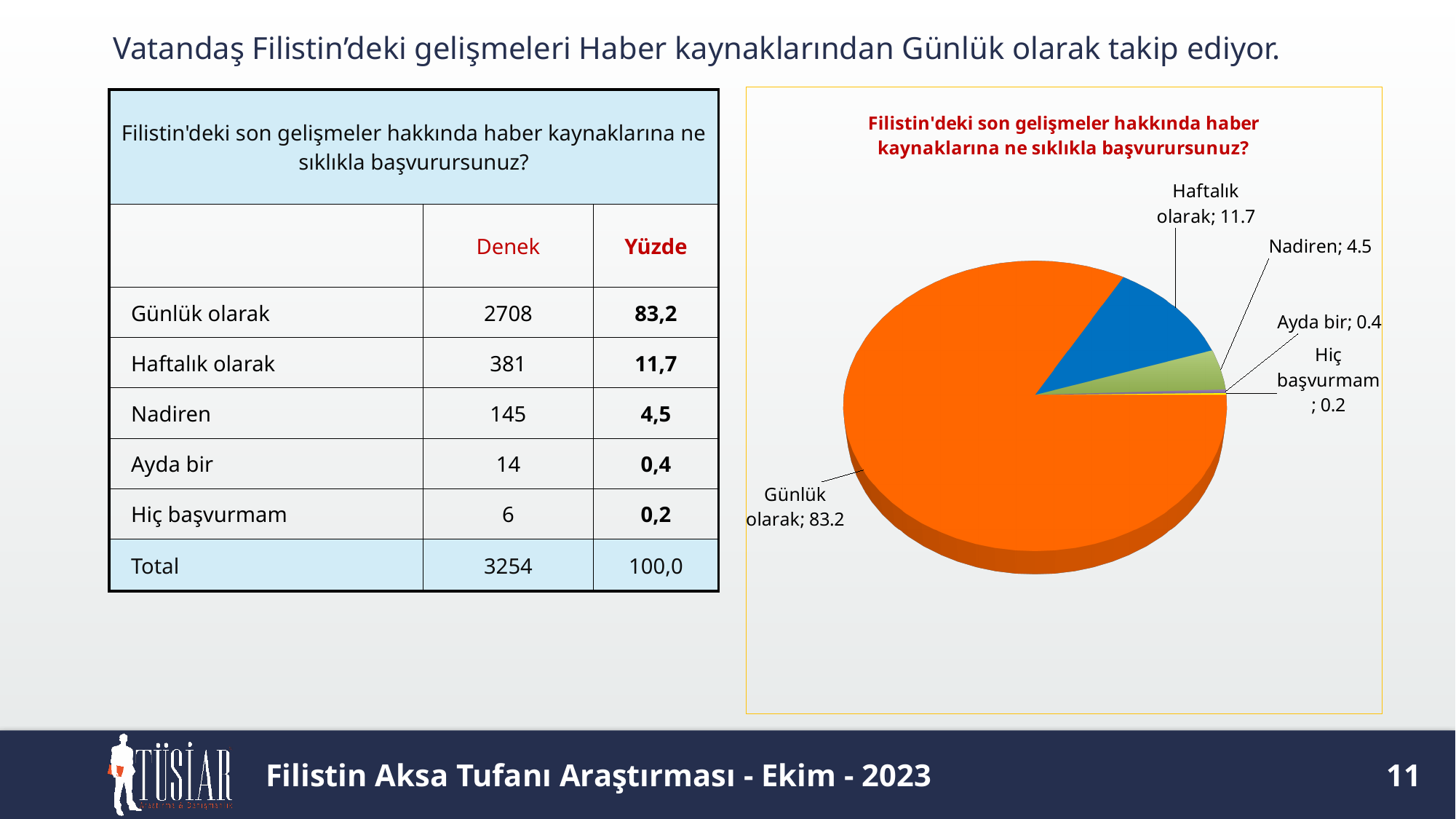
Which is larger in the pie chart, Haftalık olarak or Nadiren? Haftalık olarak What is the value for Günlük olarak in the pie chart? 83.2 What type of chart is shown on the slide? Pie chart What is the value for Hiç başvurmam in the pie chart? 0.2 What is the value for Ayda bir in the pie chart? 0.4 Which category has the smallest slice in the pie chart? Hiç başvurmam What is the value for Haftalık olarak in the pie chart? 11.7 What is the value for Nadiren in the pie chart? 4.5 Which category has the largest slice in the pie chart? Günlük olarak What colour is the Haftalık olarak slice in the pie chart? Blue How many slices does the pie chart have? 5 What is the difference between the values for Günlük olarak and Haftalık olarak in the pie chart? 71.5